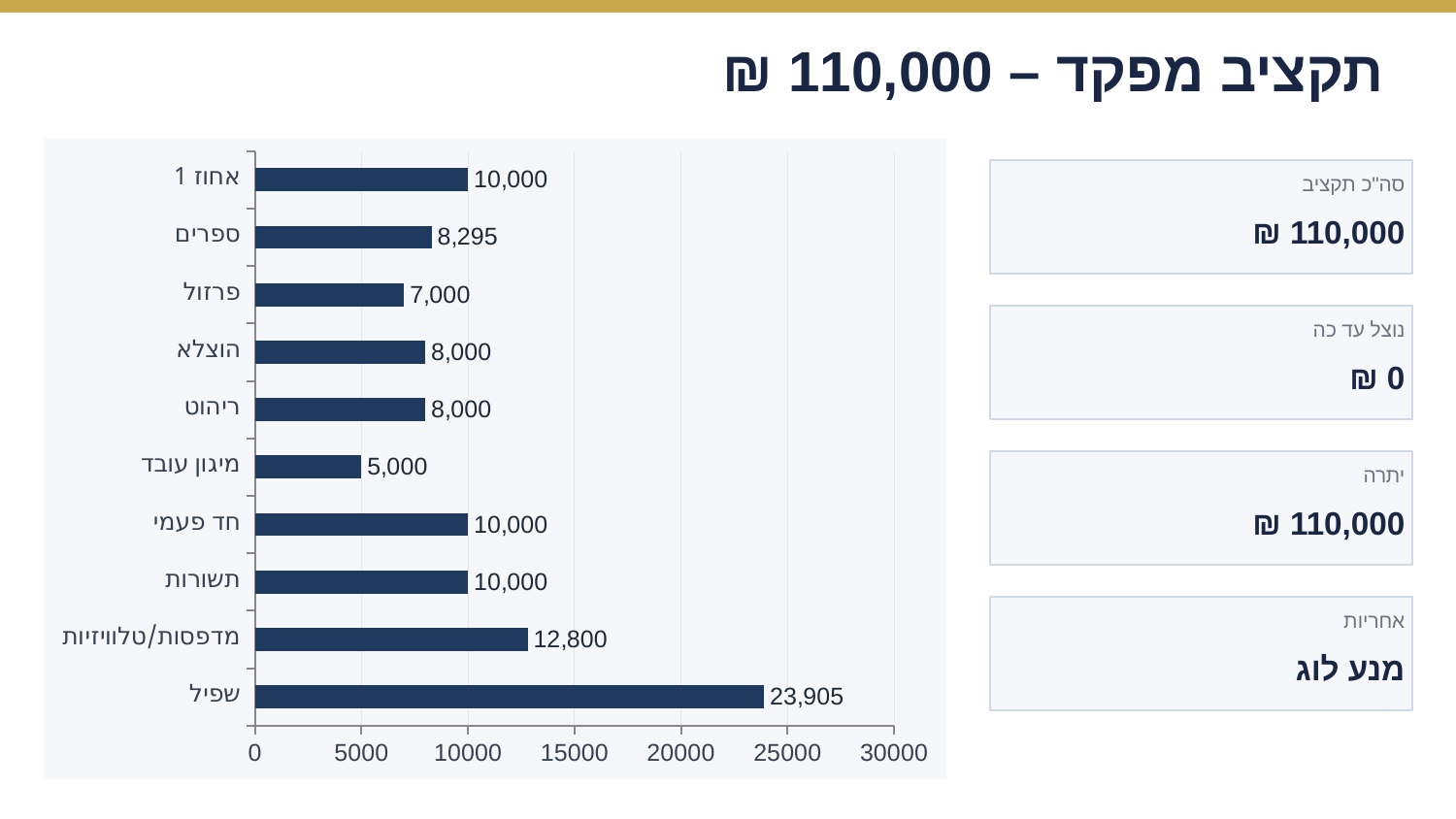
What is the value for ספרים? 8,295 What is the title of the slide? תקציב מפקד – 110,000 ₪ How many categories are shown in the chart? 10 What kind of chart is shown on the slide? bar chart Which is larger, the value for פרזול or the value for ריהוט? ריהוט Which category has the lowest value? מיגון עובד What is the difference between the values for שפיל and מדפסות/טלוויזיות? 11,105 Is the value for שפיל greater or less than 20000? greater What is the value for מיגון עובד? 5,000 What is the value for מדפסות/טלוויזיות? 12,800 What is the value for שפיל? 23,905 Which category has the highest value? שפיל